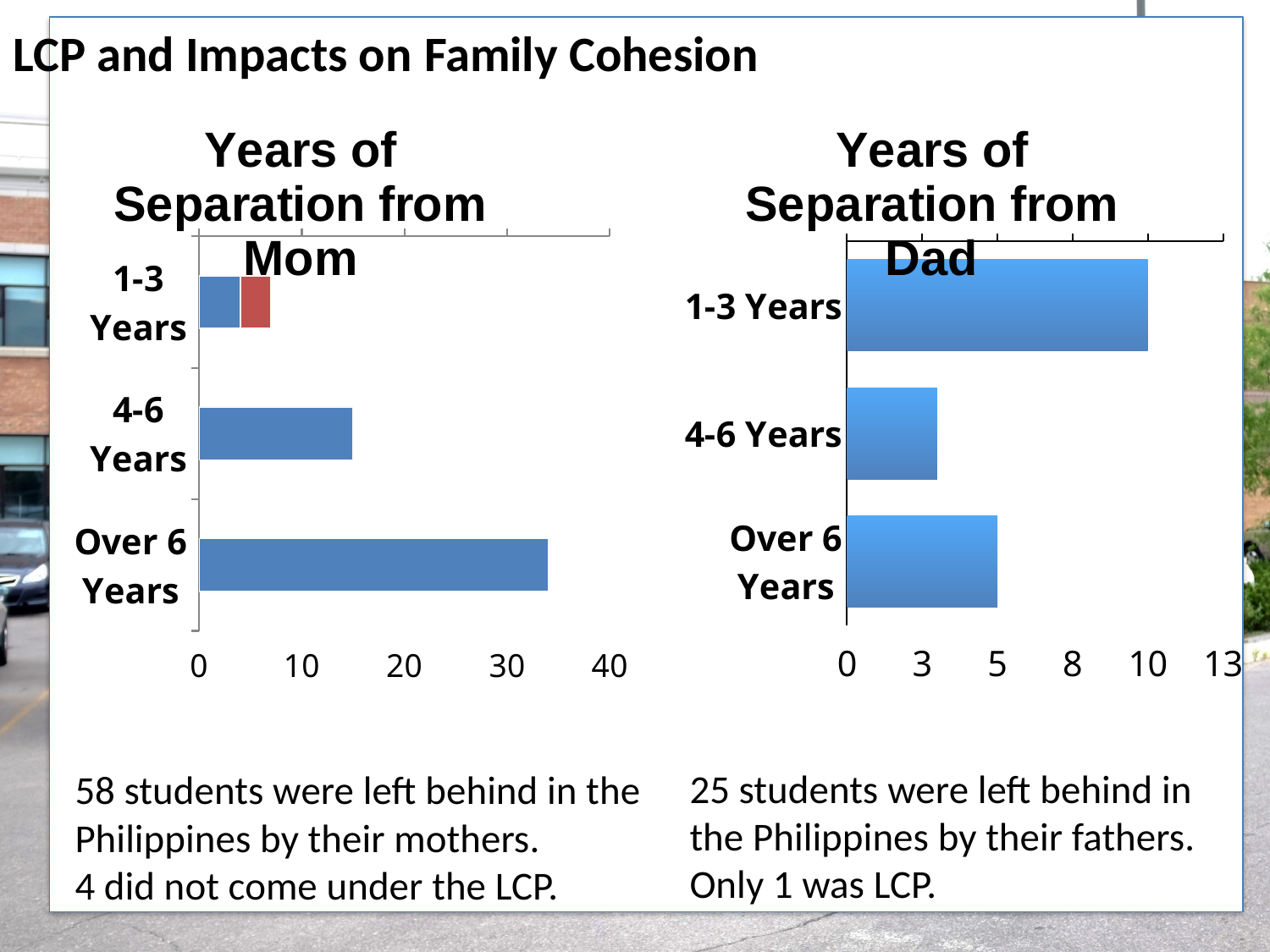
In the 'Years of Separation from Dad' chart, which category has the highest value? 1-3 Years In the 'Years of Separation from Mom' chart, which category's bar is shown in two colours? 1-3 Years In the 'Years of Separation from Mom' chart, is the value for Over 6 Years greater or less than 30? greater In the 'Years of Separation from Dad' chart, what is the value for Over 6 Years? 5 In the 'Years of Separation from Mom' chart, is the value for 4-6 Years greater or less than 20? less In the 'Years of Separation from Mom' chart, which category has the lowest value? 1-3 Years How many categories does the 'Years of Separation from Dad' chart show? 3 In the 'Years of Separation from Dad' chart, what is the value for 1-3 Years? 10 In the 'Years of Separation from Mom' chart, which category has the highest value? Over 6 Years What kind of chart is the 'Years of Separation from Mom' chart? bar chart In the 'Years of Separation from Mom' chart, is the value for 1-3 Years greater or less than 10? less In the 'Years of Separation from Dad' chart, which is larger: 4-6 Years or Over 6 Years? Over 6 Years